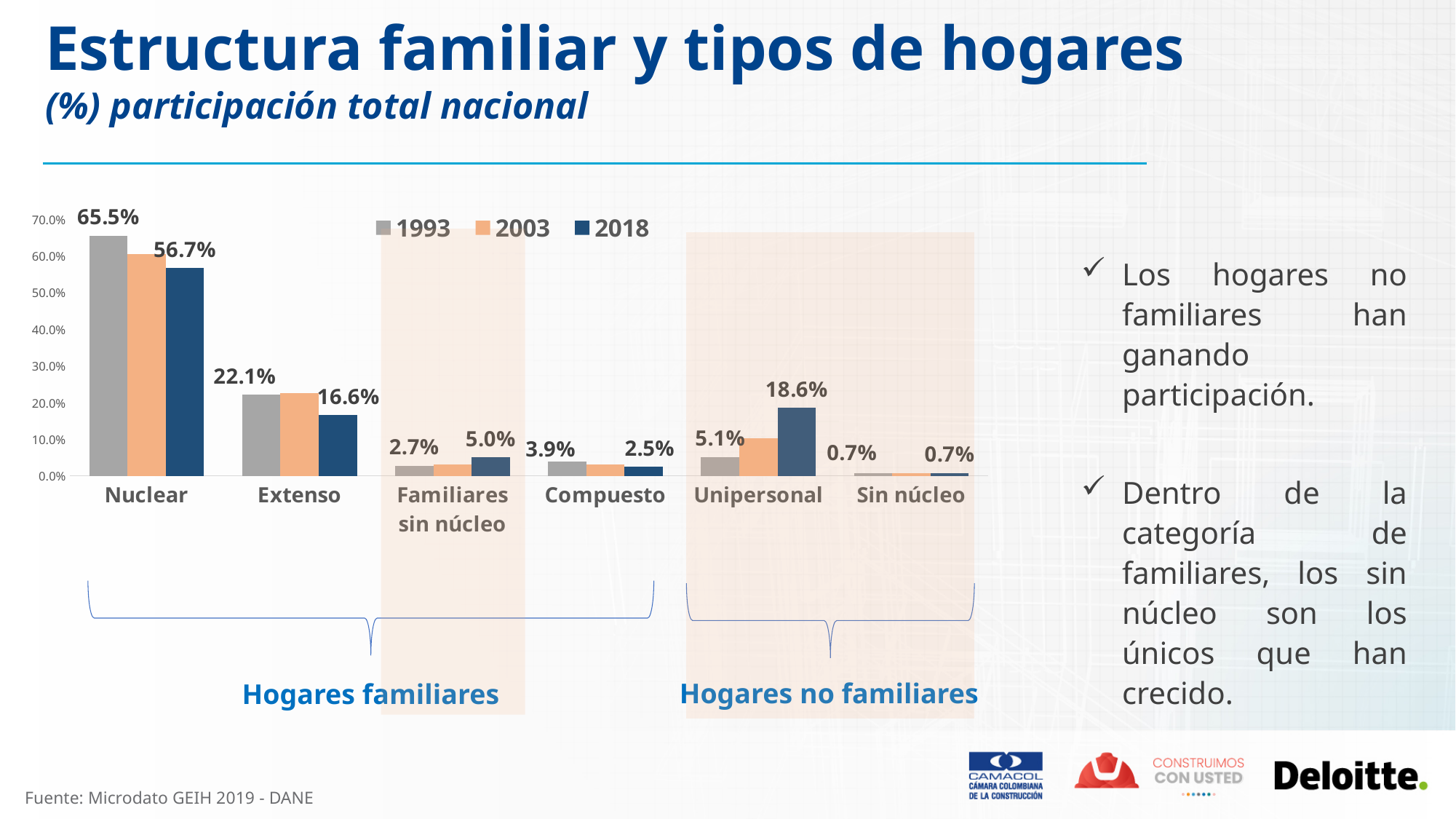
How many categories are shown on the x axis? 6 What is the difference between the 1993 and 2018 values for Nuclear? 8.8% What is the difference between the 2018 and 1993 values for Unipersonal? 13.5% What is the 1993 value for Compuesto? 3.9% Which category has the lowest 1993 value? Sin núcleo Which category has the highest 2018 value? Nuclear What is the 2018 value for Unipersonal? 18.6% How many series does the legend list? 3 What is the 1993 value for Nuclear? 65.5% What is the 2018 value for Familiares sin núcleo? 5.0% Which is larger for Extenso: the 1993 value or the 2018 value? 1993 Is the 2003 value for Extenso greater or less than 20.0%? greater